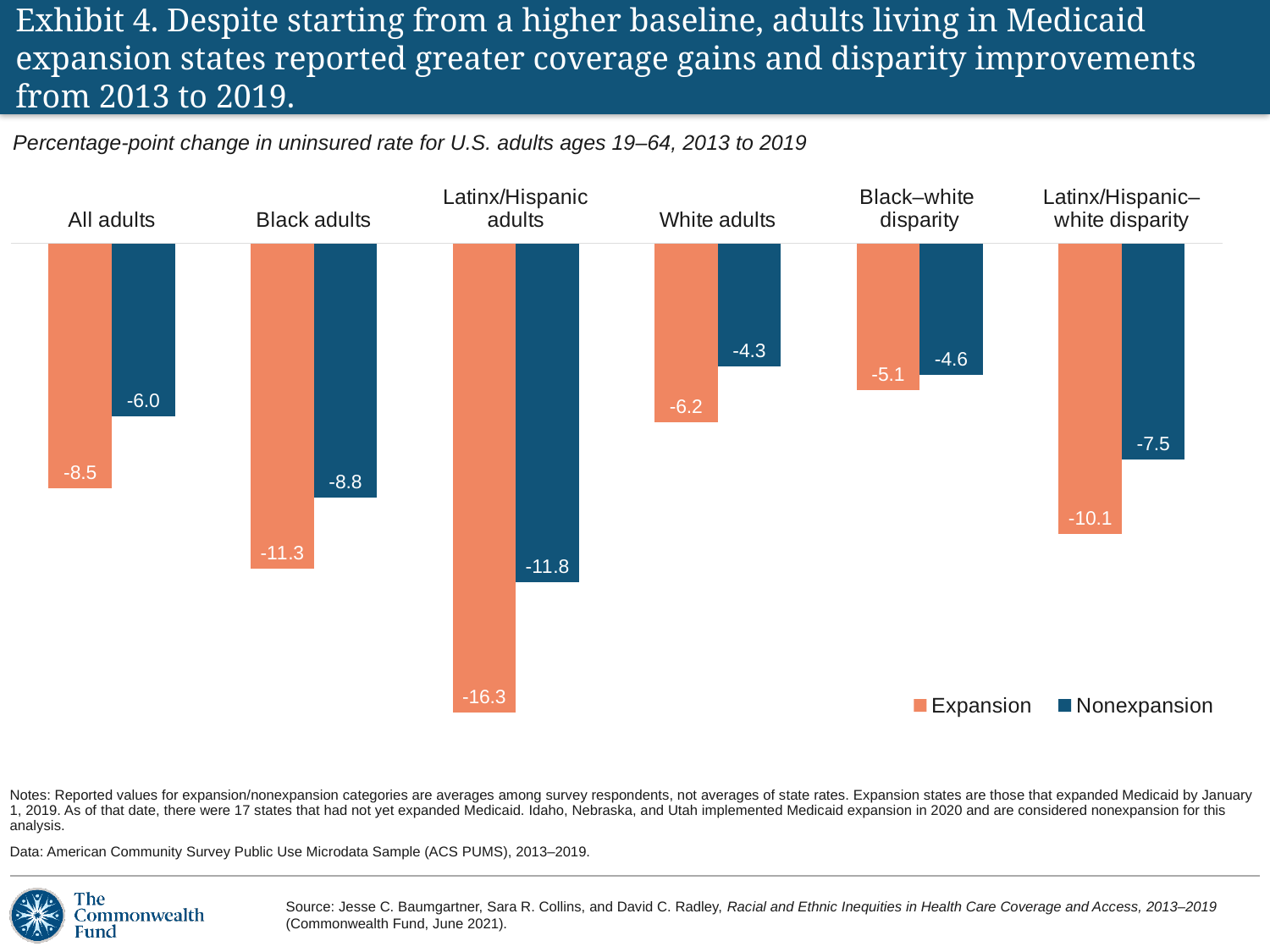
How many series does the legend list? 2 What is the Nonexpansion value for White adults? -4.3 For Black adults, which series shows the larger decline in the uninsured rate, Expansion or Nonexpansion? Expansion What is the Expansion value for All adults? -8.5 For Latinx/Hispanic adults, what is the difference in percentage points between the Expansion and Nonexpansion values? 4.5 How many categories are shown on the x axis of the chart? 6 Which category shows the largest decline (most negative value) in the Expansion series? Latinx/Hispanic adults What kind of chart is shown on the slide? Bar chart What is the Expansion value for the Black–white disparity category? -5.1 For All adults, what is the difference in percentage points between the Expansion and Nonexpansion values? 2.5 What is the Nonexpansion value for Latinx/Hispanic adults? -11.8 Which category shows the smallest decline (value closest to zero) in the Nonexpansion series? White adults